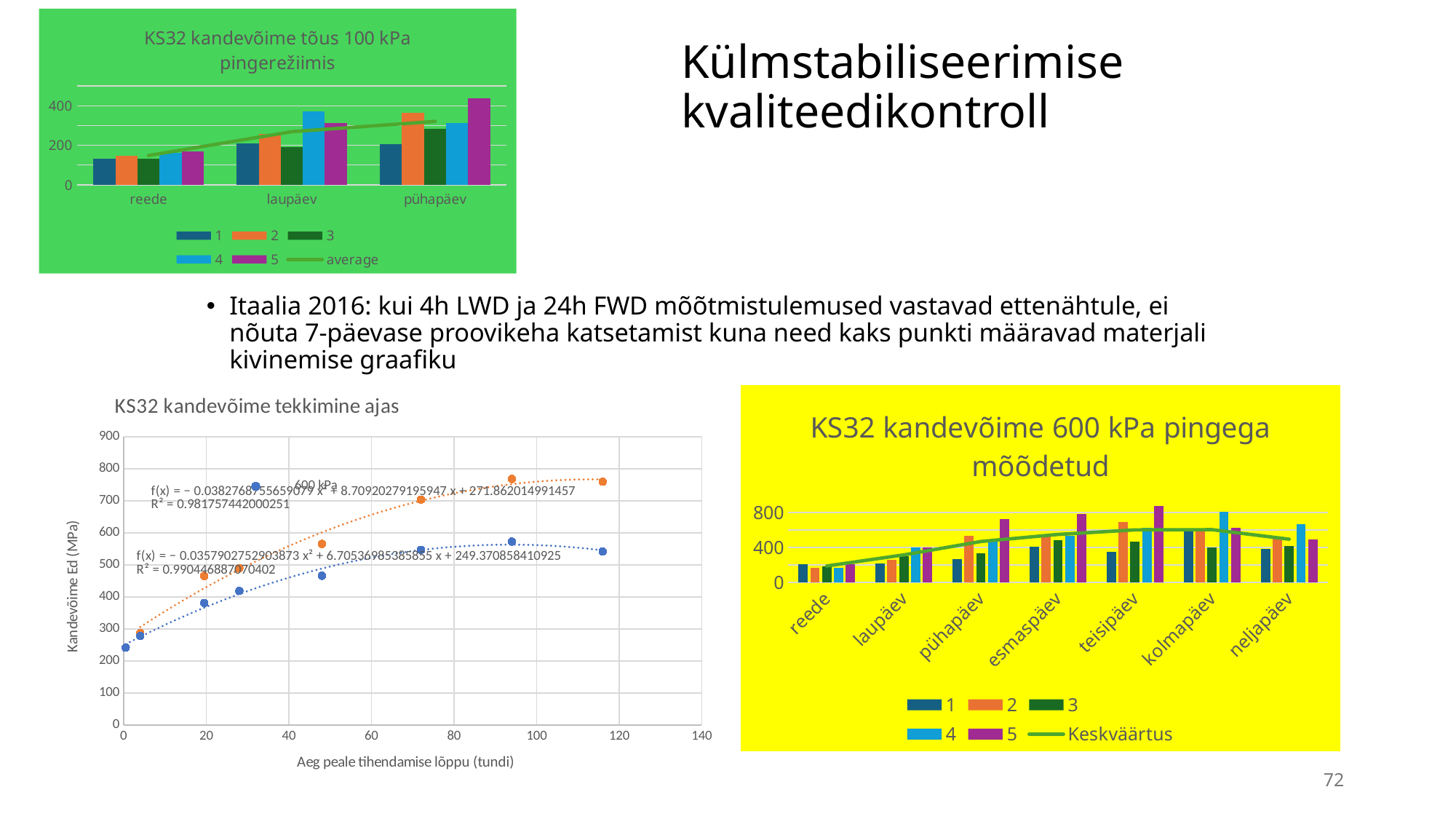
In the top-left chart 'KS32 kandevõime tõus 100 kPa pingerežiimis', does the 'average' line rise or fall from reede to pühapäev? rises In the top-left chart 'KS32 kandevõime tõus 100 kPa pingerežiimis', for which category is the series 5 bar highest? pühapäev In the top-left chart 'KS32 kandevõime tõus 100 kPa pingerežiimis', how many entries does the legend list? 6 In the top-left chart 'KS32 kandevõime tõus 100 kPa pingerežiimis', how many categories are shown on the x axis? 3 In the bottom-right chart 'KS32 kandevõime 600 kPa pingega mõõdetud', how many categories are shown on the x axis? 7 What kind of chart is the bottom-left chart titled 'KS32 kandevõime tekkimine ajas'? scatter chart In the top-left chart 'KS32 kandevõime tõus 100 kPa pingerežiimis', is the value of series 1 for reede greater or less than 200? less In the bottom-right chart 'KS32 kandevõime 600 kPa pingega mõõdetud', which is larger for pühapäev: series 1 or series 5? series 5 What kind of chart is the top-left chart titled 'KS32 kandevõime tõus 100 kPa pingerežiimis'? combination bar and line chart In the bottom-left chart 'KS32 kandevõime tekkimine ajas', what is the title of the x axis? Aeg peale tihendamise lõppu (tundi) In the top-left chart 'KS32 kandevõime tõus 100 kPa pingerežiimis', is the value of series 5 for pühapäev greater or less than 400? greater In the bottom-right chart 'KS32 kandevõime 600 kPa pingega mõõdetud', is the value of series 5 for kolmapäev greater or less than 800? less